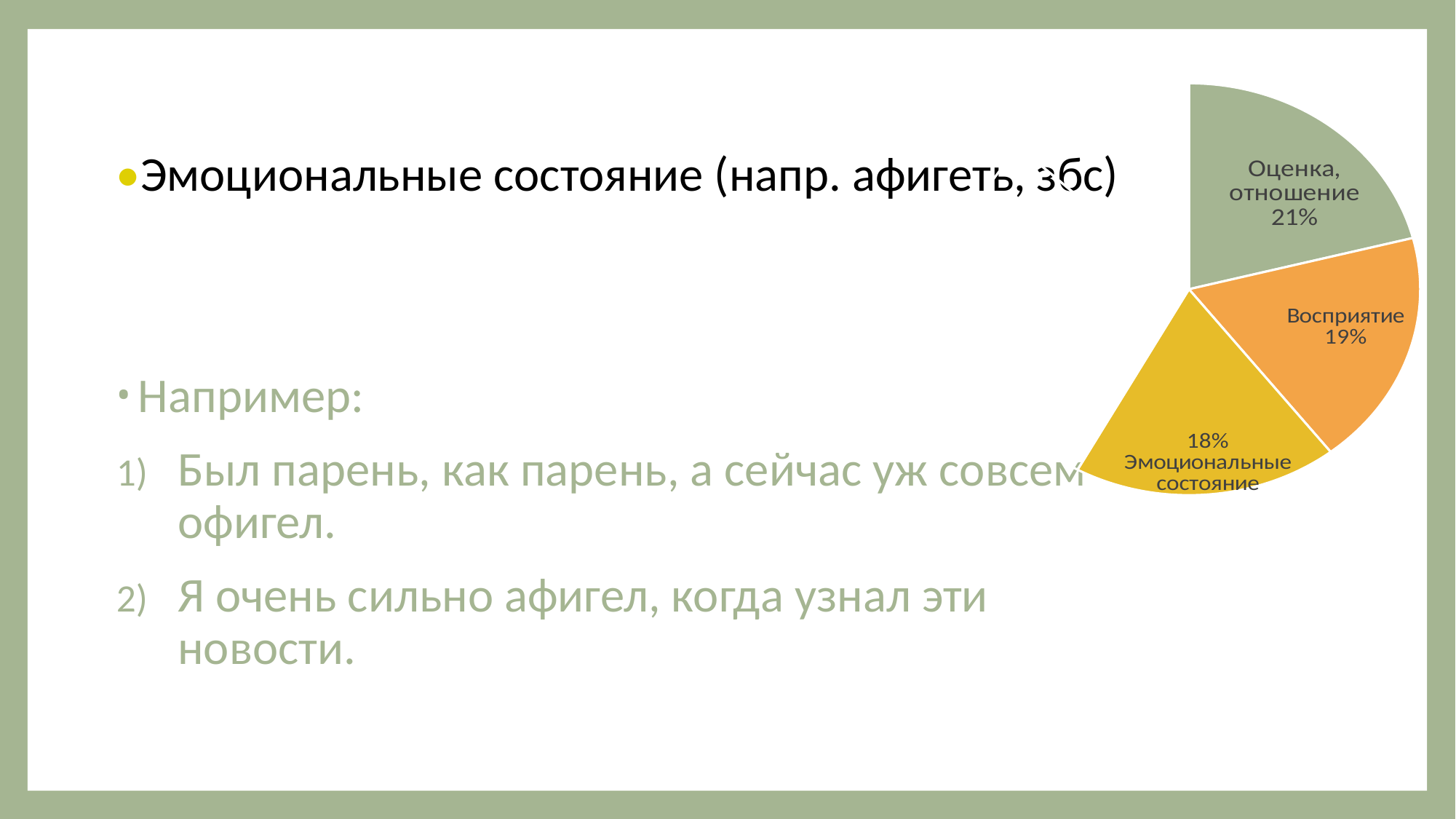
Which of the labelled slices has the largest percentage? Оценка, отношение What kind of chart is shown on the slide? pie chart What percentage is shown for the slice labelled "Эмоциональные состояние"? 18% Which of the labelled slices has the smallest percentage? Эмоциональные состояние Which slice is larger, "Оценка, отношение" or "Восприятие"? Оценка, отношение What percentage is shown for the slice labelled "Оценка, отношение"? 21% What is the difference in percentage points between "Оценка, отношение" and "Эмоциональные состояние"? 3 What percentage is shown for the slice labelled "Восприятие"? 19% What is the difference in percentage points between "Восприятие" and "Эмоциональные состояние"? 1 How many slices of the pie chart have readable labels on the slide? 3 Which slice is larger, "Восприятие" or "Эмоциональные состояние"? Восприятие What colour is the slice labelled "Восприятие"? orange